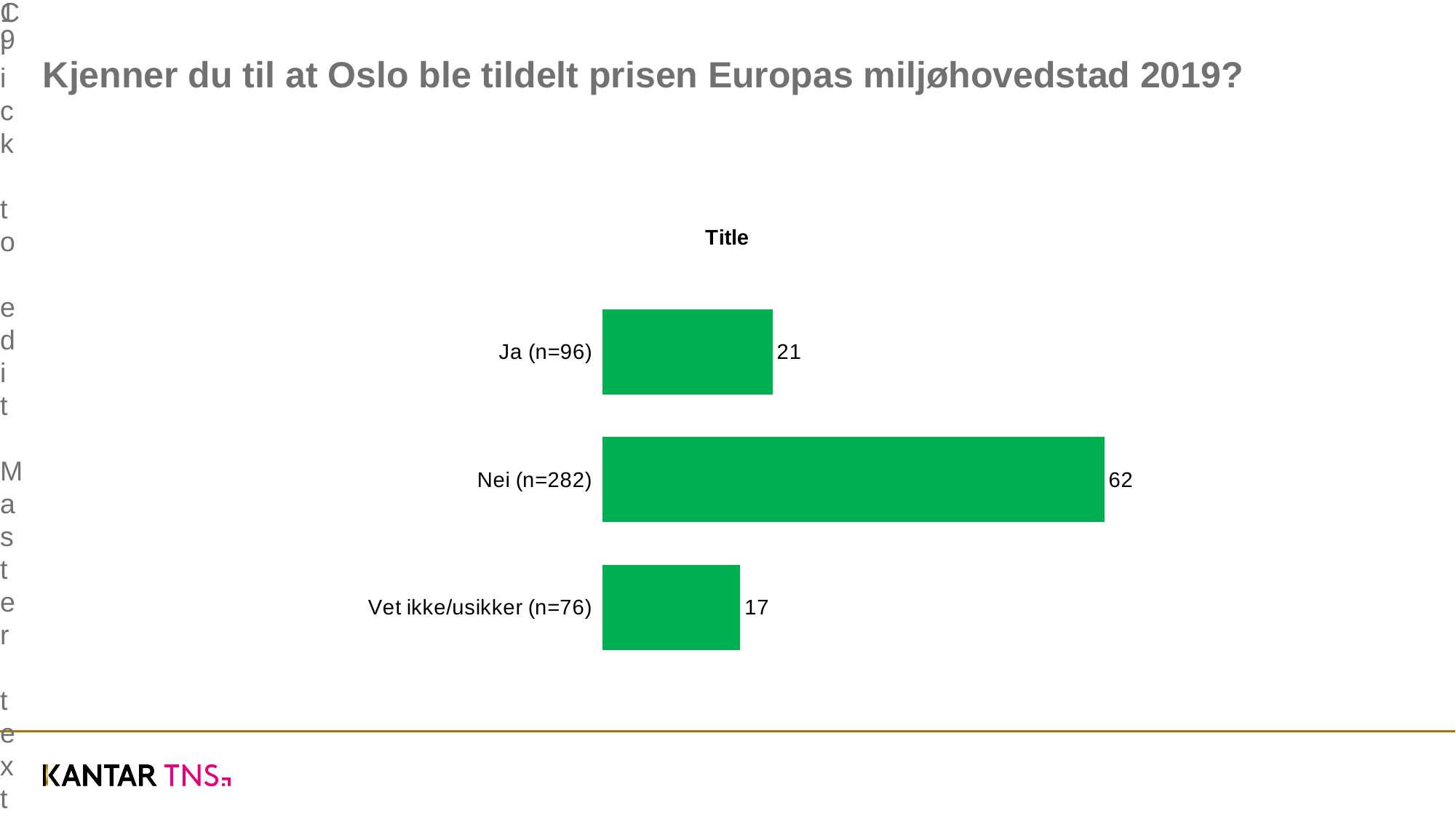
Which category has the lowest value? Vet ikke/usikker (n=76) What is the total of the three values shown in the chart? 100 What is the value for Nei (n=282)? 62 What is the difference between the values for Ja (n=96) and Vet ikke/usikker (n=76)? 4 What is the value for Vet ikke/usikker (n=76)? 17 Which is larger, the value for Ja (n=96) or the value for Vet ikke/usikker (n=76)? Ja (n=96) What is the difference between the values for Nei (n=282) and Ja (n=96)? 41 What is the value for Ja (n=96)? 21 What kind of chart is shown on the slide? Bar chart How many categories are shown in the chart? 3 Which category has the highest value? Nei (n=282) What colour are the bars in the chart? Green